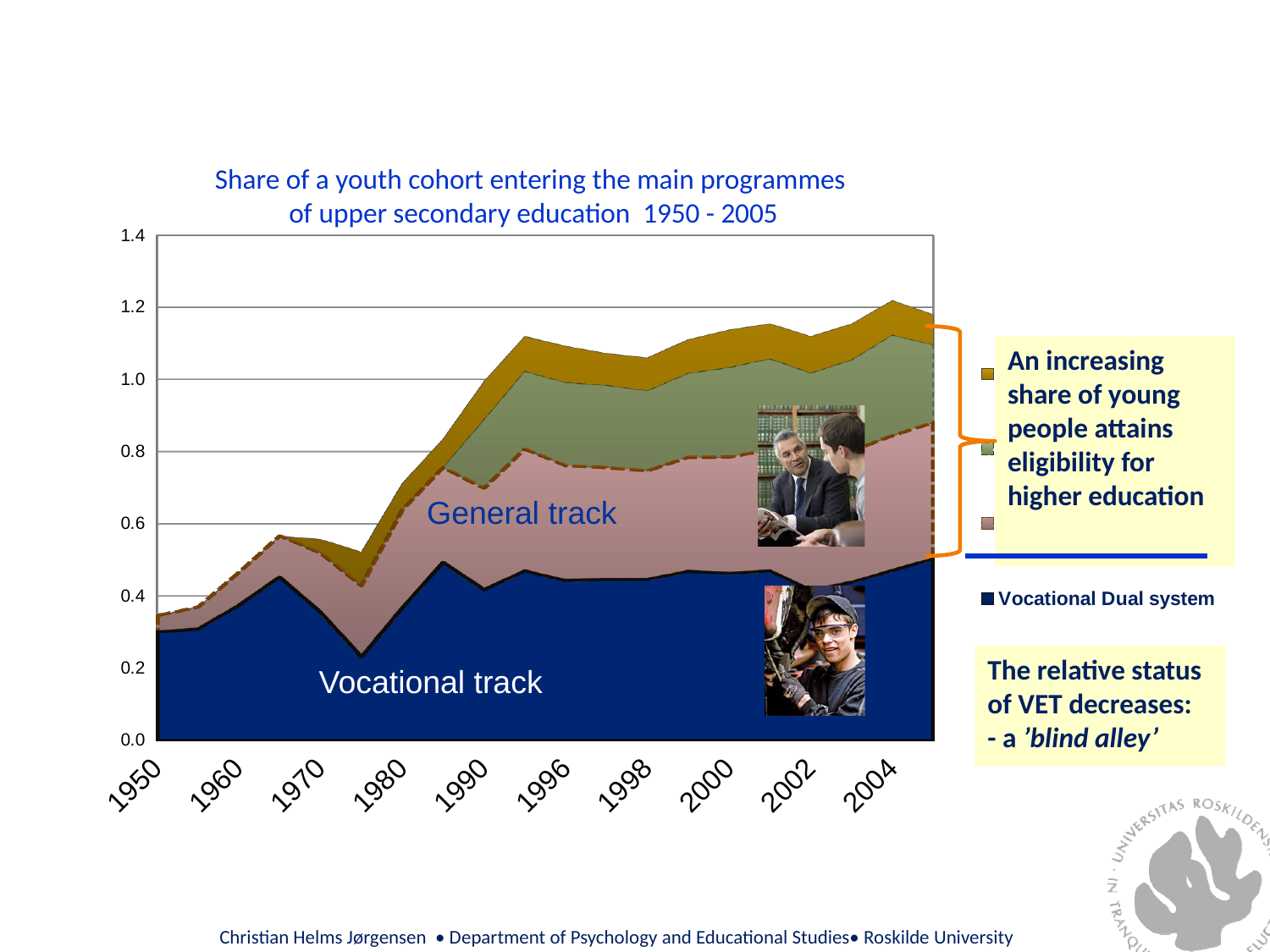
Which area is labelled at the bottom of the chart? Vocational track Is the top of the stacked areas in 1980 greater or less than 0.6? greater How many year labels are shown on the x axis of the chart? 10 Is the value of the Vocational track in 1950 greater or less than 0.4? less Is the top of the stacked areas in 2004 greater or less than 1.0? greater What kind of chart is shown on the slide? Stacked area chart Which is larger: the top of the stacked areas in 1960 or in 2000? 2000 Does the total share (top of the stacked areas) rise or fall between 1950 and 2004? rise What is the highest value shown on the y axis of the chart? 1.4 What is the title of the chart? Share of a youth cohort entering the main programmes of upper secondary education 1950 - 2005